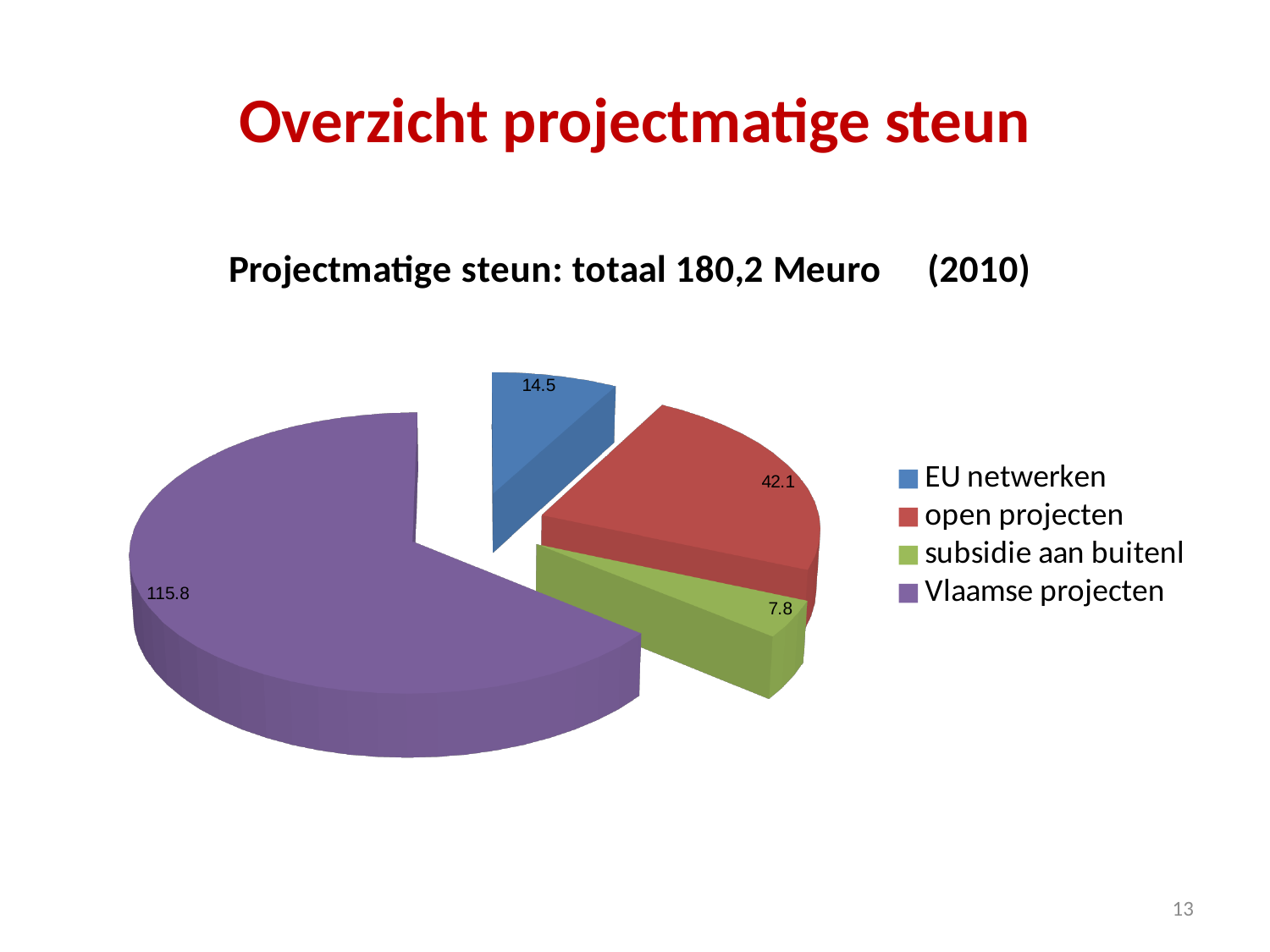
What kind of chart is shown on the slide? Pie chart What is the title of the chart? Projectmatige steun: totaal 180,2 Meuro (2010) What value is shown for the EU netwerken slice? 14.5 Which category has the smallest slice of the pie? subsidie aan buitenl What value is shown for the subsidie aan buitenl slice? 7.8 How many categories does the pie chart show? 4 Which is larger, the value for EU netwerken or the value for subsidie aan buitenl? EU netwerken Which category has the largest slice of the pie? Vlaamse projecten What value is shown for the open projecten slice? 42.1 What value is shown for the Vlaamse projecten slice? 115.8 What is the difference between the values for Vlaamse projecten and open projecten? 73.7 What is the difference between the values for open projecten and EU netwerken? 27.6